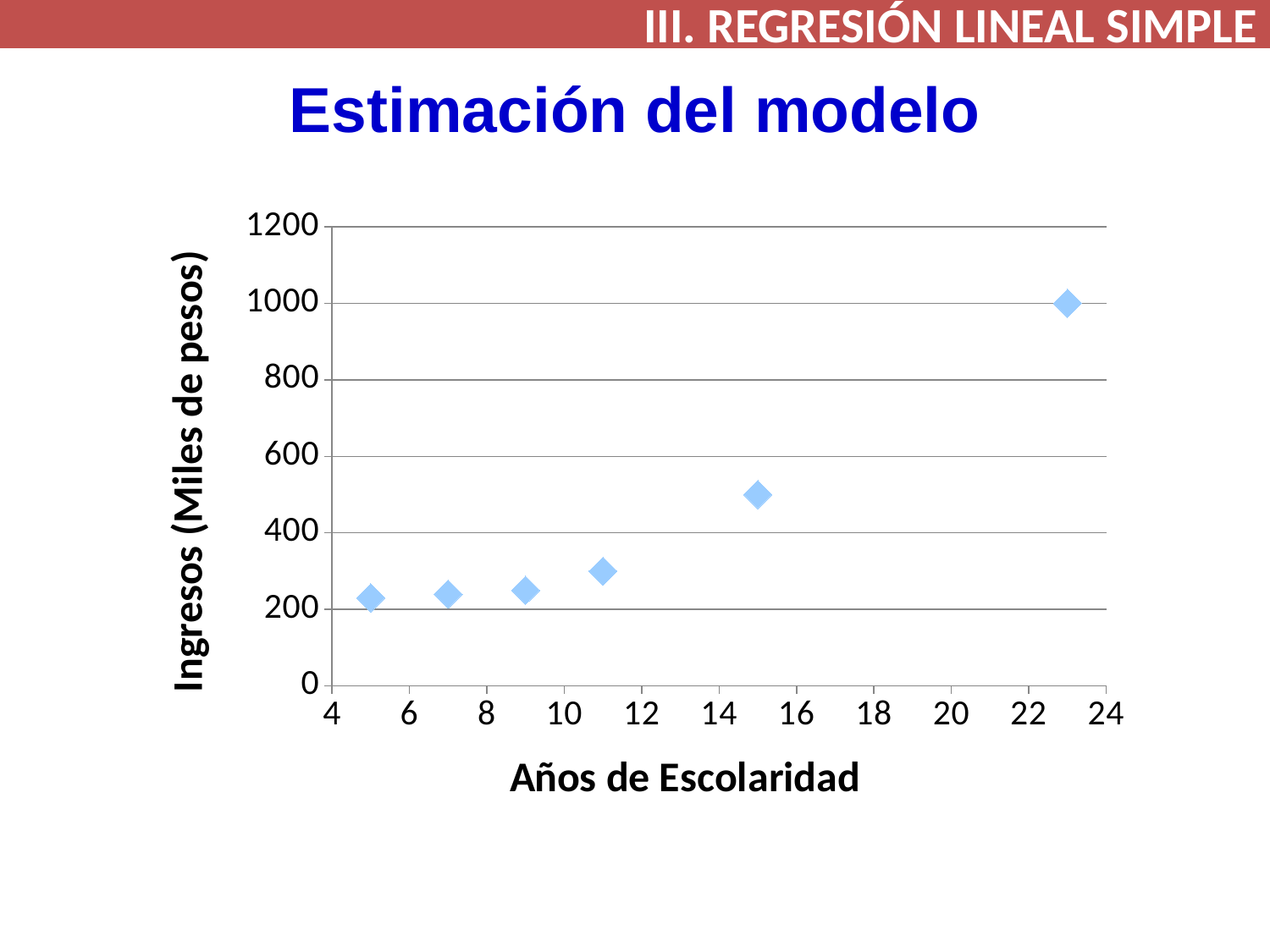
Which has the larger income value: 11 years of schooling or 15 years of schooling? 15 years of schooling What is the title of the y axis? Ingresos (Miles de pesos) What is the title of the x axis? Años de Escolaridad Is the income value at 5 years of schooling greater or less than 400? less Do the income values generally rise or fall as years of schooling increase? rise At which value of Años de Escolaridad is the income highest? 23 Is the income value at 23 years of schooling greater or less than 800? greater How many data points are plotted on the chart? 6 Is the income value at 11 years of schooling greater or less than 400? less What kind of chart is shown on the slide? scatter chart